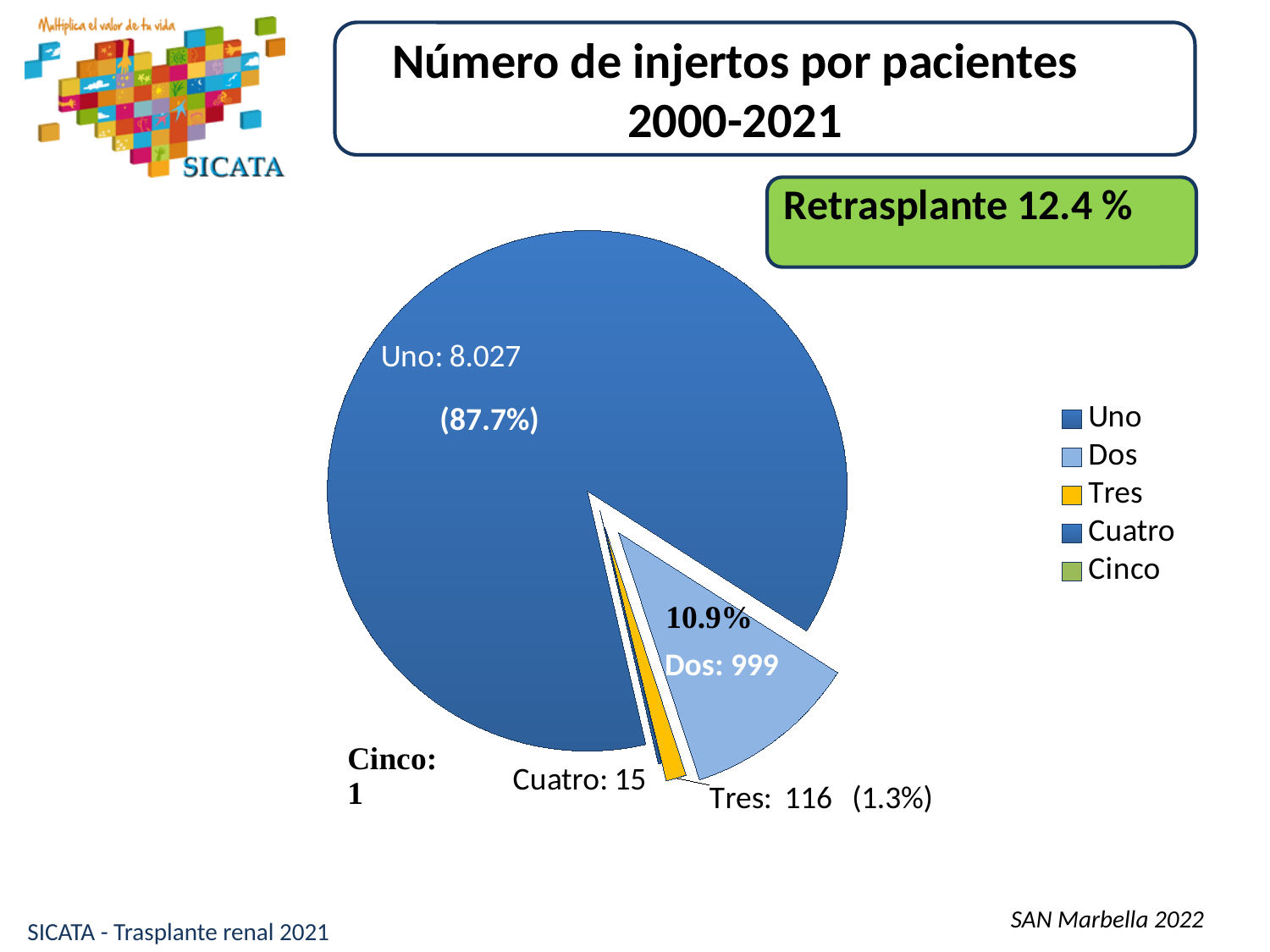
What share of the pie does the "Dos" slice represent? 10.9% How many entries does the legend list? 5 What is the value for the "Uno" slice? 8.027 What is the value for the "Cinco" slice? 1 Which category has the largest slice of the pie? Uno What is the difference between the values for "Dos" and "Tres"? 883 What is the value for the "Cuatro" slice? 15 What is the value for the "Dos" slice? 999 What kind of chart is shown on the slide? pie chart What share of the pie does the "Uno" slice represent? 87.7% Which category has the smallest slice of the pie? Cinco What is the value for the "Tres" slice? 116